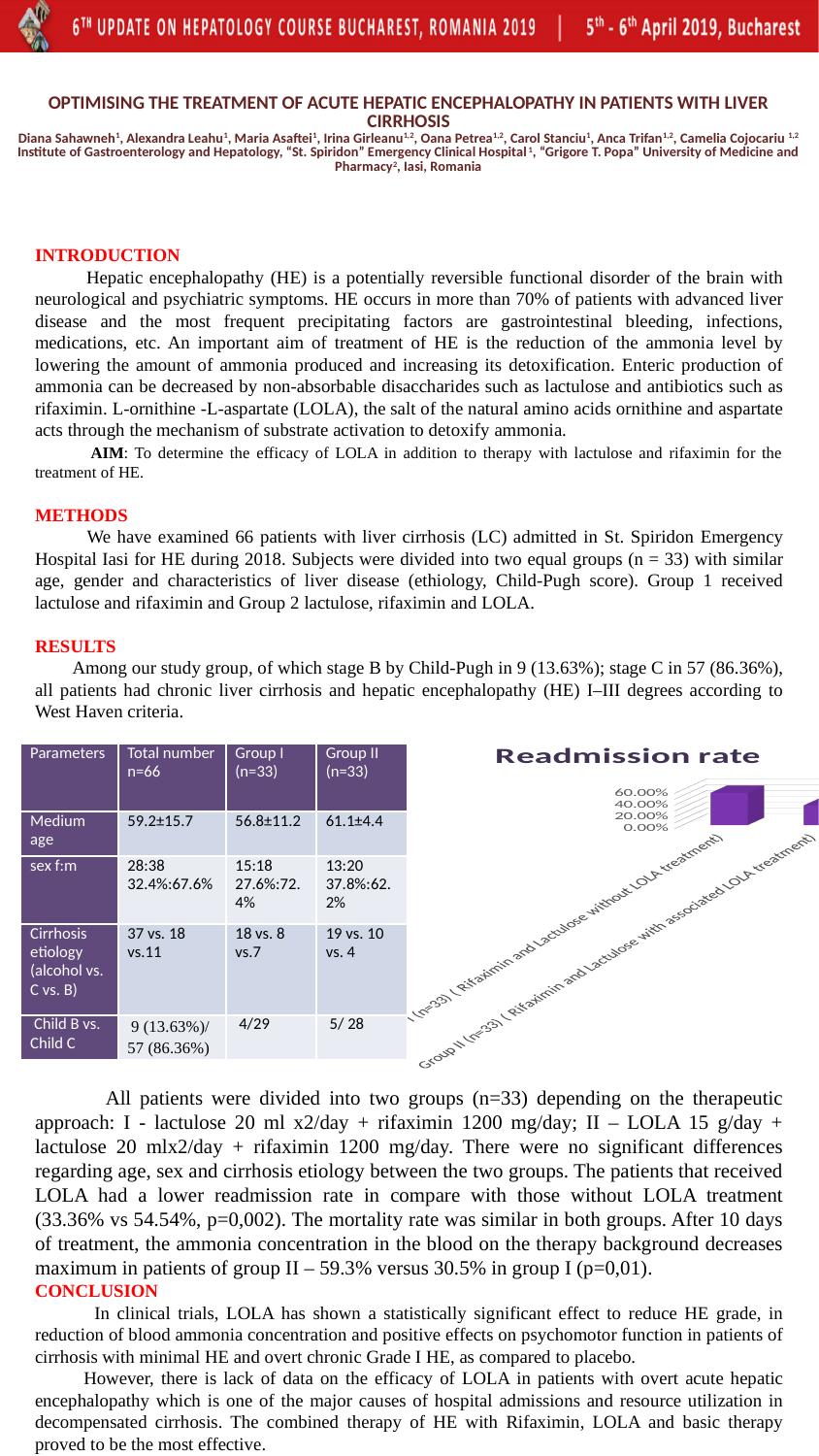
In the Readmission rate chart, is the readmission rate for Group I (without LOLA treatment) greater or less than 20.00%? greater What kind of chart is the Readmission rate chart? bar chart In the Readmission rate chart, is the readmission rate for Group I (without LOLA treatment) greater or less than 40.00%? greater What is the highest value shown on the vertical axis of the Readmission rate chart? 60.00% How many groups (categories) are plotted in the Readmission rate chart? 2 What is the title of the chart on the slide? Readmission rate In the Readmission rate chart, which group has the higher readmission rate? Group I (n=33) (Rifaximin and Lactulose without LOLA treatment) In the Readmission rate chart, which group has the lower readmission rate? Group II (n=33) (Rifaximin and Lactulose with associated LOLA treatment) In the Readmission rate chart, is the bar for Group I taller or shorter than the bar for Group II? taller In the Readmission rate chart, does the readmission rate rise or fall from Group I to Group II? fall